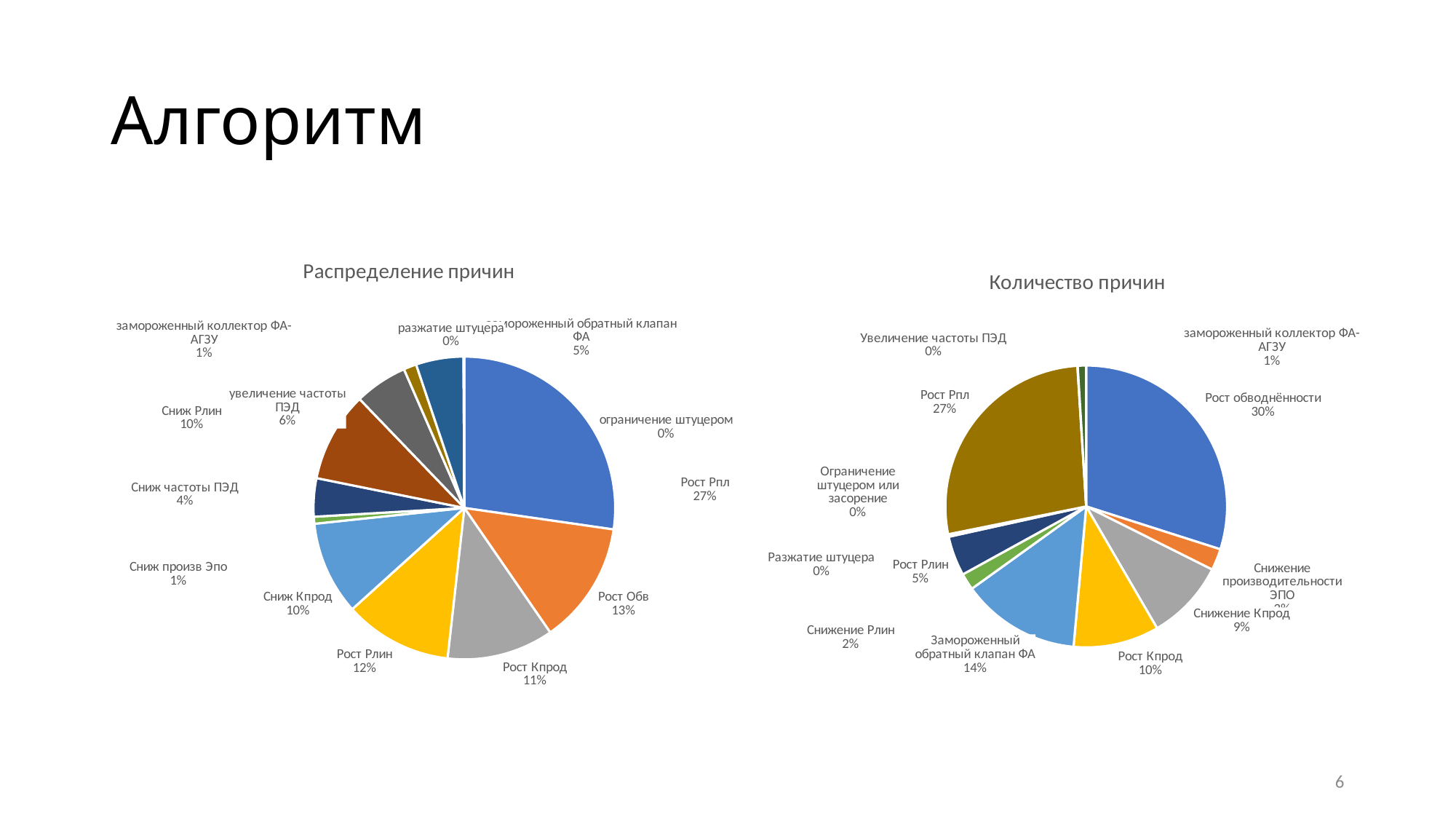
In the chart titled "Распределение причин", what is the difference between the shares of "Рост Обв" and "Рост Кпрод"? 2% In the chart titled "Распределение причин", which is larger: "Рост Рлин" or "Сниж Кпрод"? Рост Рлин In the chart titled "Распределение причин", which category has the largest share? Рост Рпл In the chart titled "Распределение причин", how many categories are shown? 13 In the chart titled "Количество причин", what share does "Рост обводнённости" have? 30% In the chart titled "Количество причин", what share does "Замороженный обратный клапан ФА" have? 14% In the chart titled "Распределение причин", what share does "Рост Рпл" have? 27% In the chart titled "Количество причин", how many categories are shown? 12 What type of chart is the chart titled "Количество причин"? Pie chart In the chart titled "Количество причин", what is the difference between the shares of "Рост Кпрод" and "Рост Рлин"? 5% In the chart titled "Количество причин", which category has the largest share? Рост обводнённости In the chart titled "Распределение причин", what share does "Сниж частоты ПЭД" have? 4%